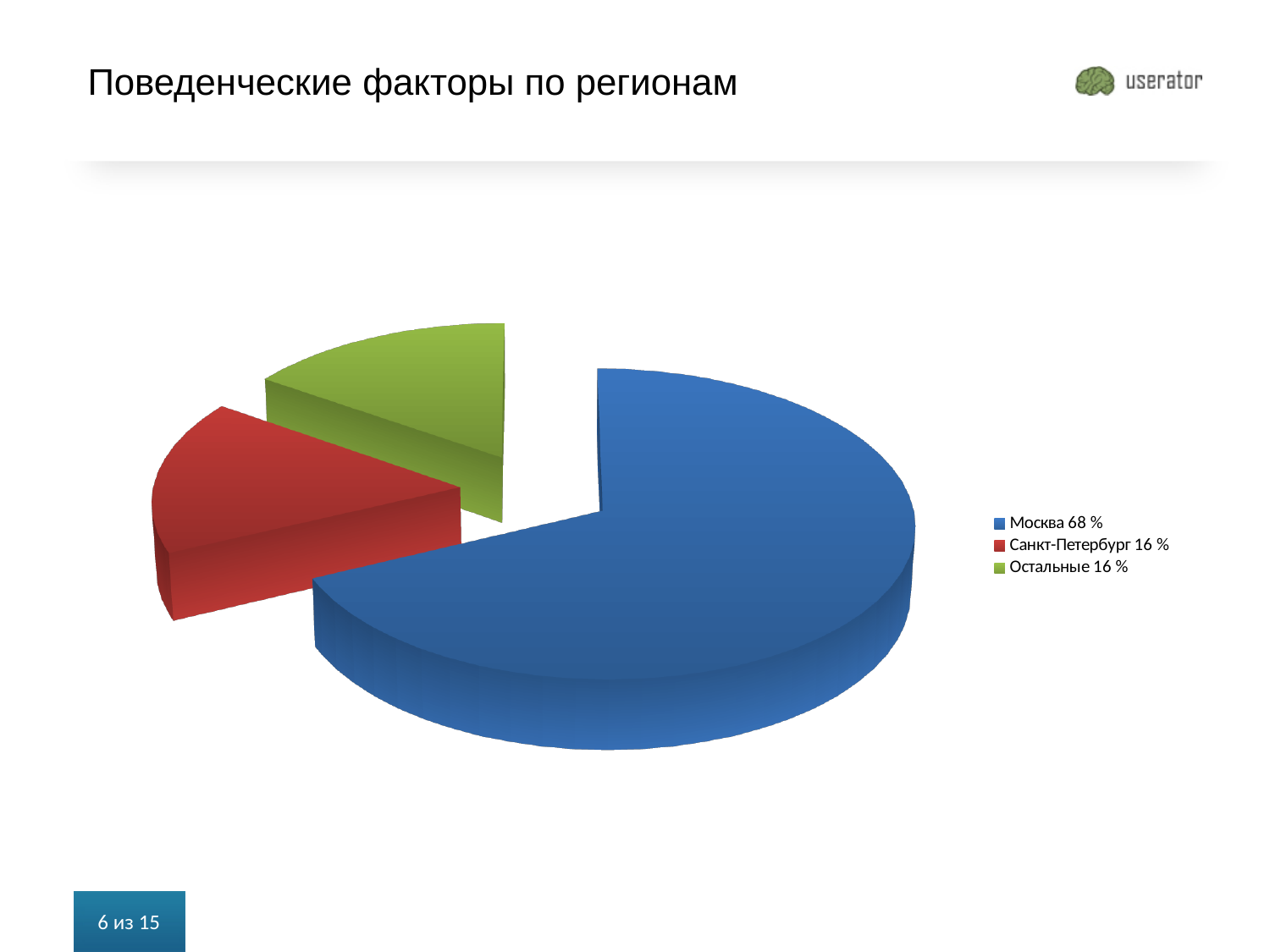
What share of the pie does Москва have? 68 % Which region has the largest slice of the pie? Москва What colour is the slice for Санкт-Петербург? red What is the difference between the shares of Москва and Санкт-Петербург? 52 % What kind of chart is shown on the slide? pie chart What share of the pie does Остальные have? 16 % How many slices does the pie chart have? 3 What share of the pie does Санкт-Петербург have? 16 % How many entries does the legend list? 3 What is the title of the slide containing the chart? Поведенческие факторы по регионам Is the share for Москва greater or less than 50 %? greater Which is larger, the share of Москва or the share of Остальные? Москва